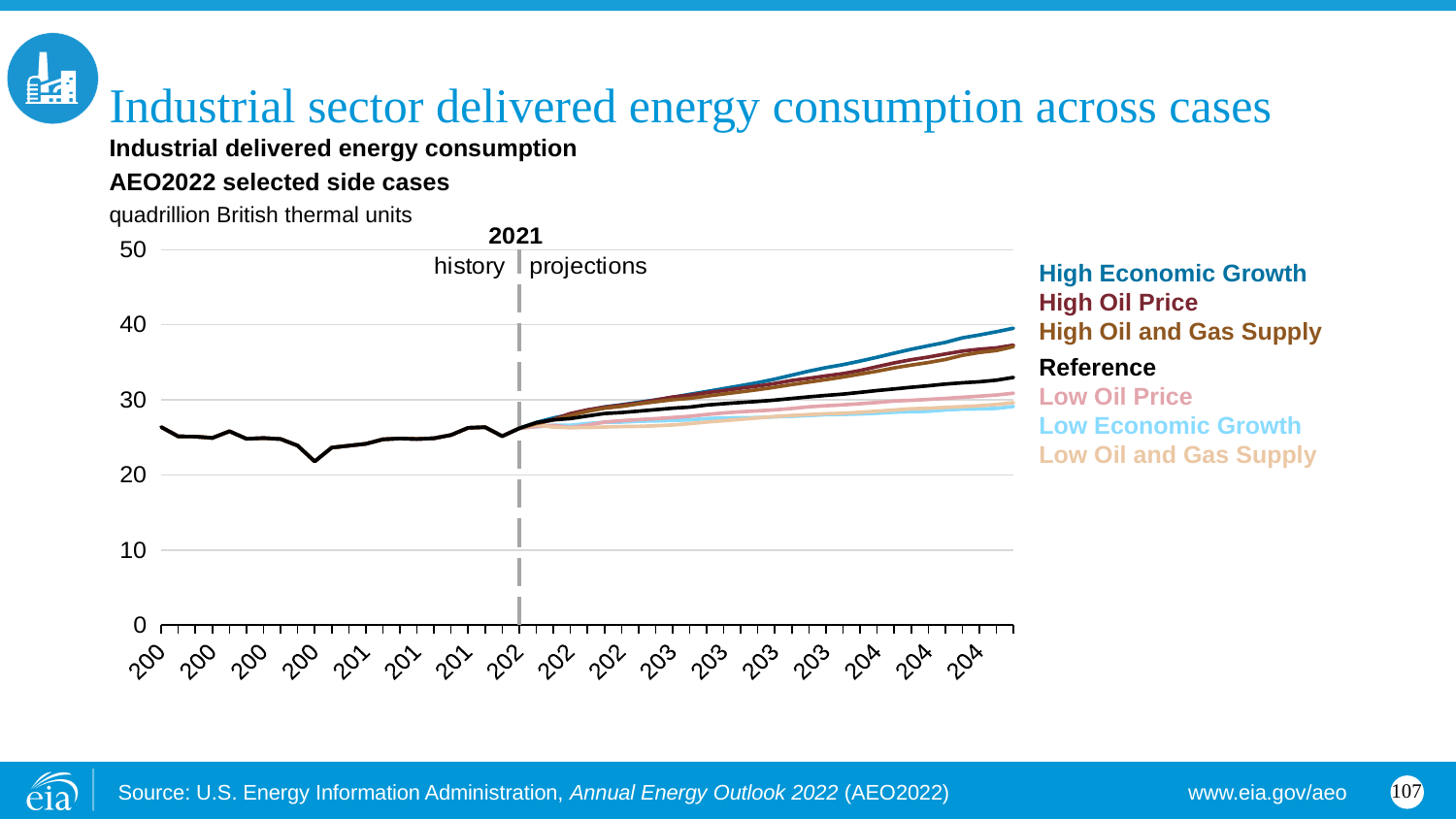
Do the values for High Economic Growth rise or fall over the projection period? rise At the end of the projection period, which is larger: High Economic Growth or Reference? High Economic Growth Do the values for Reference rise or fall over the projection period? rise Is the value for High Economic Growth at the end of the projection period greater or less than 30? greater What unit is the y axis measured in? quadrillion British thermal units How many series does the legend list? 7 At the end of the projection period, which is larger: High Oil Price or Low Oil Price? High Oil Price Is the value for Reference at the start of the projection period (2021) greater or less than 30? less Which year does the dashed vertical line separating history from projections mark? 2021 Which series has the highest value at the end of the projection period? High Economic Growth What kind of chart is shown on the slide? line chart Is the value for Reference at the end of the projection period greater or less than 30? greater